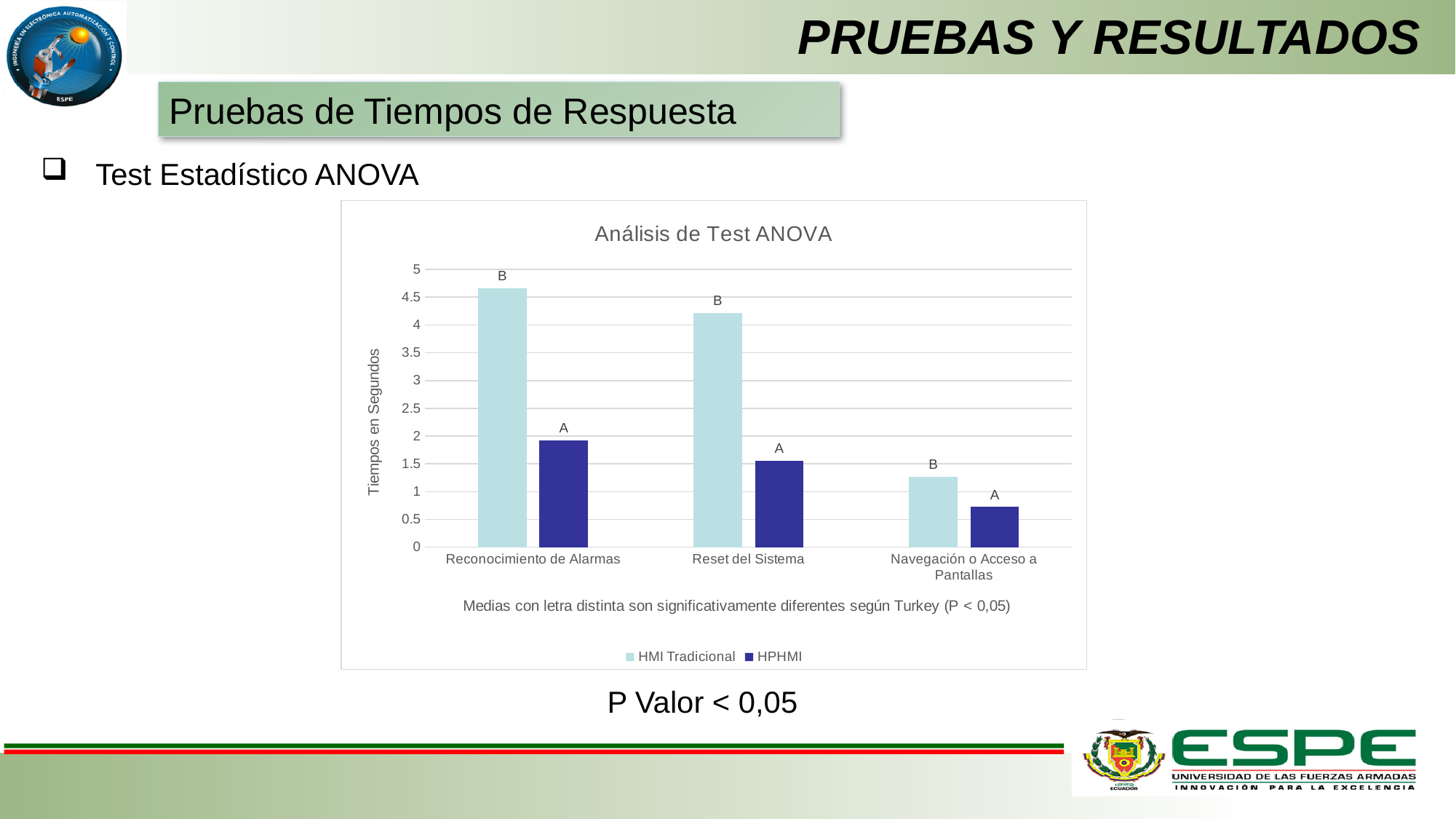
Which category has the highest HMI Tradicional value? Reconocimiento de Alarmas How many series does the chart legend list? 2 Do the HMI Tradicional values rise or fall from left to right across the categories? fall Is the HPHMI value for Navegación o Acceso a Pantallas greater or less than 1? less Is the HMI Tradicional value for Reconocimiento de Alarmas greater or less than 4? greater For Reset del Sistema, which series has the larger value, HMI Tradicional or HPHMI? HMI Tradicional Is the HPHMI value for Reset del Sistema greater or less than 2? less What is the title of the chart? Análisis de Test ANOVA What letter labels the HPHMI bars in the chart? A Which category has the lowest HPHMI value? Navegación o Acceso a Pantallas How many categories are shown on the x axis of the chart? 3 What type of chart is shown on the slide? bar chart